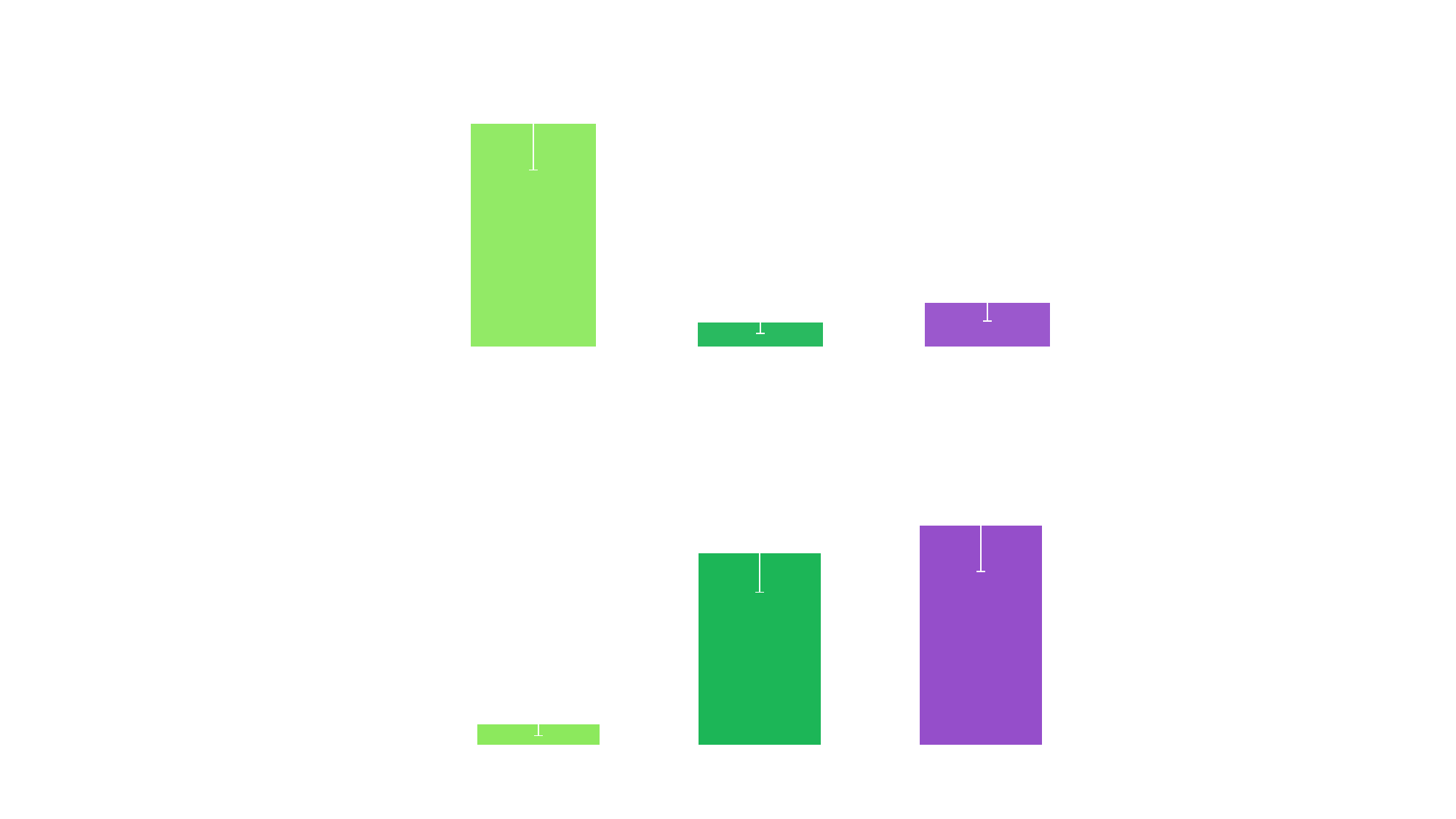
How many bars does the top chart show? 3 What kind of chart is the top chart on the slide? bar chart What colour is the tallest bar in the top chart? light green What kind of chart is the bottom chart on the slide? bar chart What colour is the tallest bar in the bottom chart? purple In the bottom chart, is the middle (green) bar taller or shorter than the right (purple) bar? shorter In the top chart, which bar is the tallest: the left, middle or right one? left How many bars does the bottom chart show? 3 In the bottom chart, which bar is the shortest: the left, middle or right one? left In the bottom chart, which bar is the tallest: the left, middle or right one? right In the top chart, is the right (purple) bar taller or shorter than the middle (green) bar? taller In the top chart, which bar is the shortest: the left, middle or right one? middle